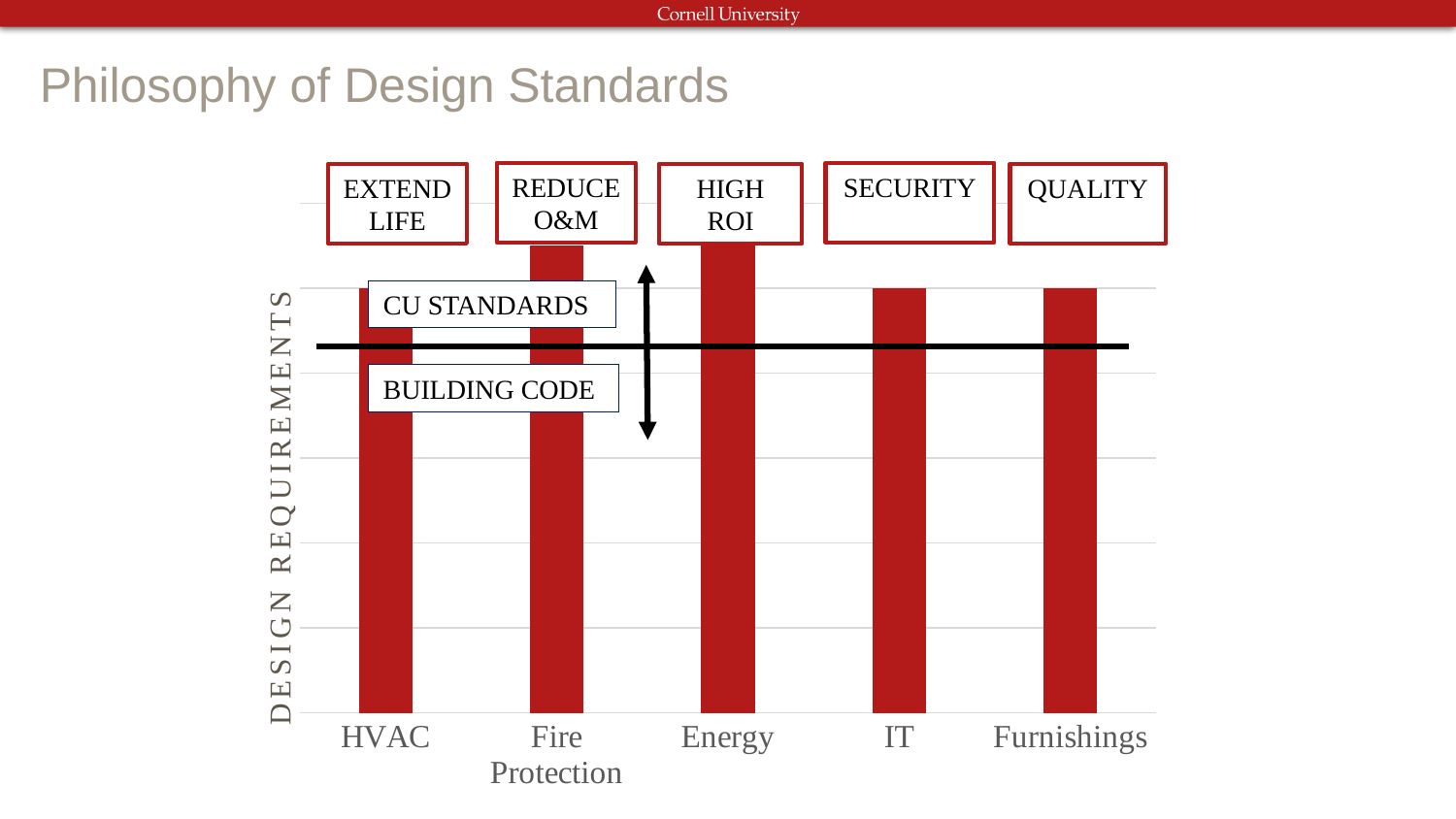
What is the label of the first category on the x axis of the chart? HVAC What is the label of the last category on the x axis of the chart? Furnishings Which is larger in the chart, the bar for Fire Protection or the bar for HVAC? Fire Protection What is the label on the vertical axis of the chart? DESIGN REQUIREMENTS Which is larger in the chart, the bar for Fire Protection or the bar for IT? Fire Protection How many categories are shown on the x axis of the chart? 5 Which is larger in the chart, the bar for Energy or the bar for IT? Energy What colour are the bars in the chart? red What kind of chart is shown on the slide? bar chart